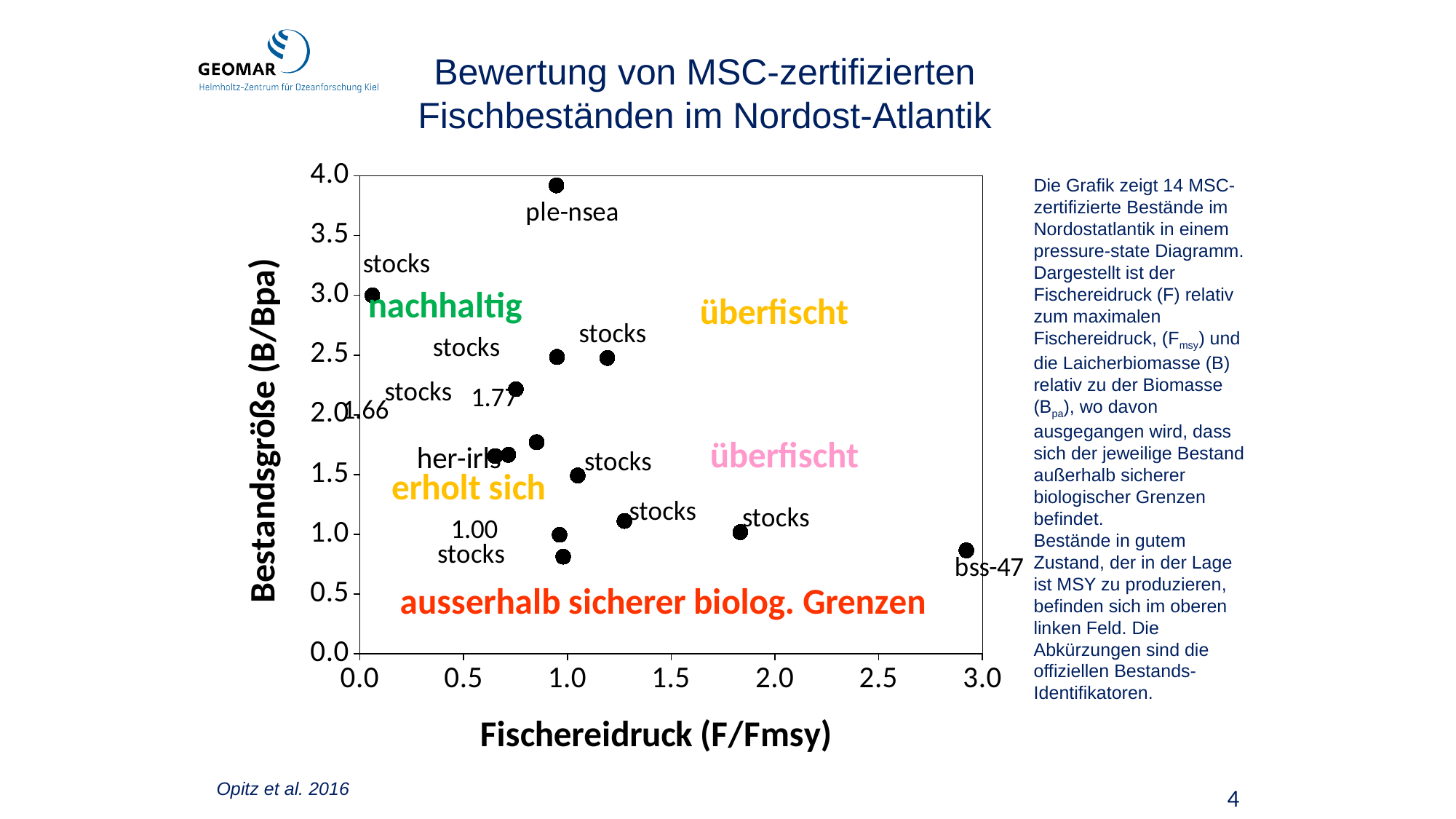
How many data points are plotted in the chart? 14 Which has the larger Fischereidruck (F/Fmsy), her-irls or bss-47? bss-47 What is the title of the y axis of the chart? Bestandsgröße (B/Bpa) What is the title of the x axis of the chart? Fischereidruck (F/Fmsy) Is the Bestandsgröße (B/Bpa) for ple-nsea greater or less than 3.5? greater What kind of chart is shown on the slide? scatter plot Is the Bestandsgröße (B/Bpa) for bss-47 greater or less than 1.0? less Is the Fischereidruck (F/Fmsy) for bss-47 greater or less than 2.5? greater Which labelled point has the highest Bestandsgröße (B/Bpa)? ple-nsea Which has the larger Bestandsgröße (B/Bpa), ple-nsea or bss-47? ple-nsea Which labelled point has the highest Fischereidruck (F/Fmsy)? bss-47